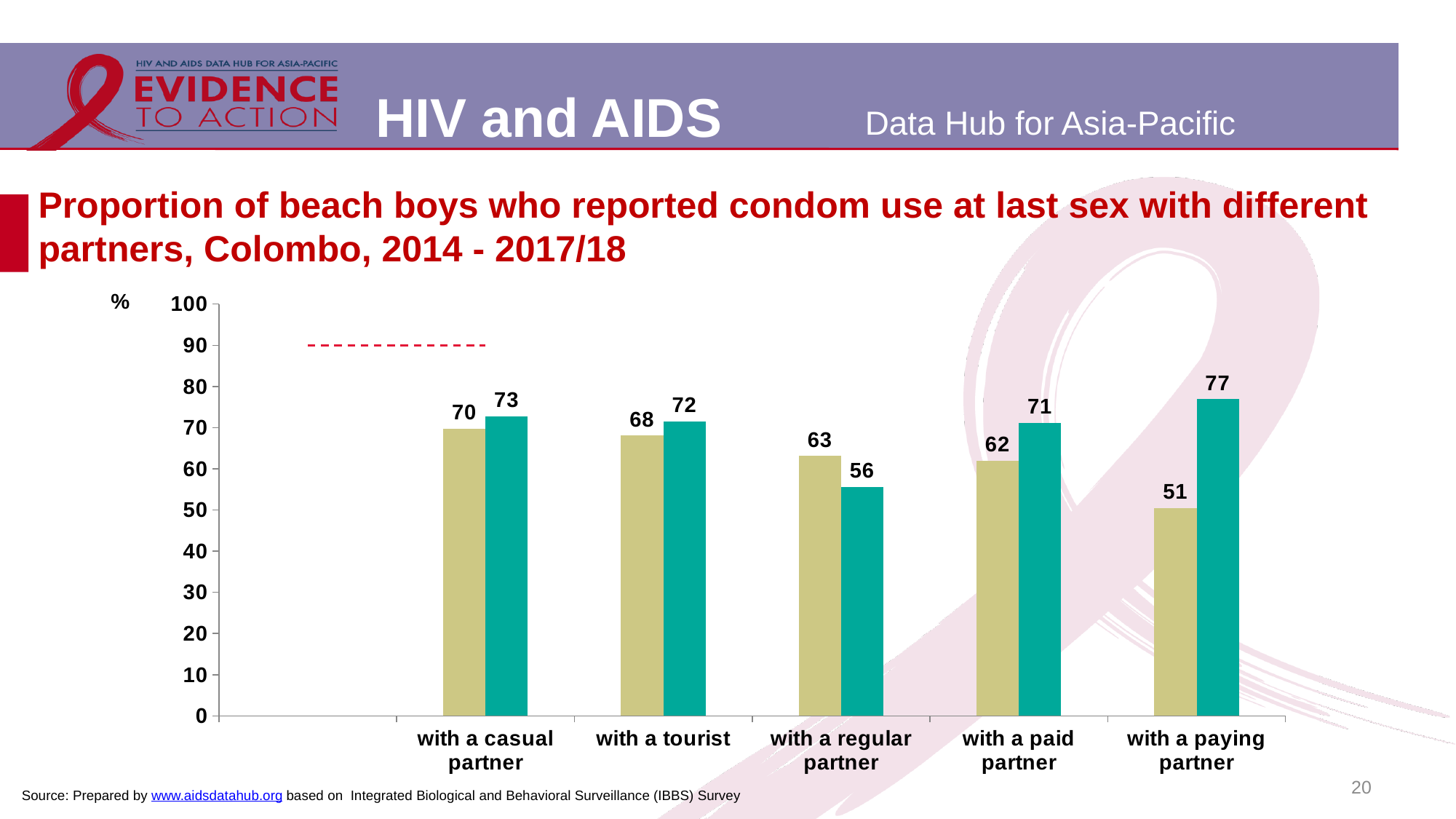
What is the value of the teal bar for 'with a paying partner'? 77 Which partner category has the highest teal bar? with a paying partner For 'with a paid partner', which bar is larger, the tan bar or the teal bar? the teal bar Which partner category has the lowest tan bar? with a paying partner How many partner categories are shown on the x axis? 5 What is the value of the tan bar for 'with a regular partner'? 63 What is the difference between the teal and tan bars for 'with a paying partner'? 26 What unit is shown on the y axis of the chart? % Is the tan bar for 'with a casual partner' greater or less than 60? greater What is the value of the tan bar for 'with a tourist'? 68 What is the difference between the tan and teal bars for 'with a regular partner'? 7 What type of chart is shown on the slide? bar chart